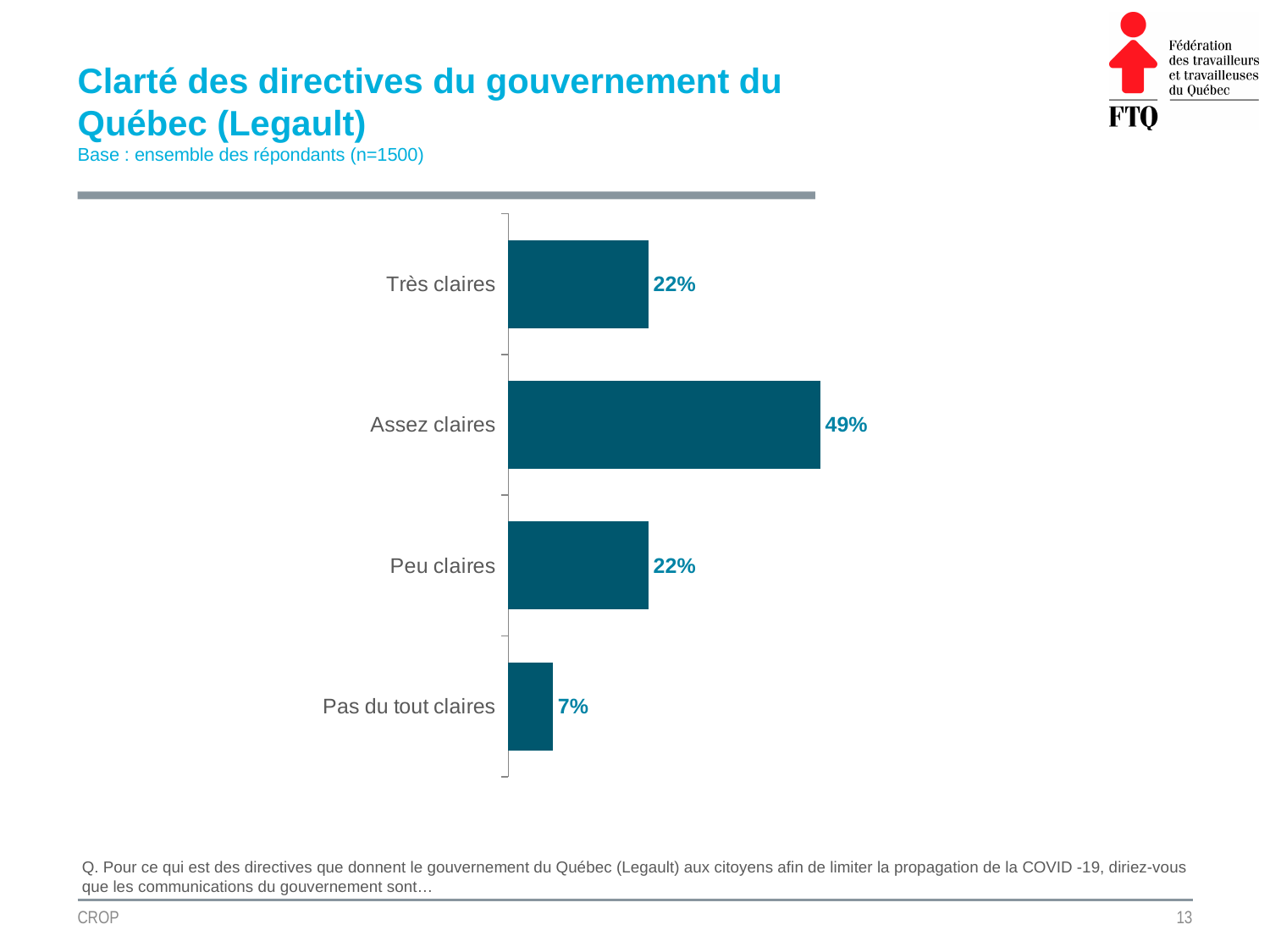
Which is larger, the value for "Assez claires" or the value for "Très claires"? Assez claires What is the difference between the values for "Peu claires" and "Pas du tout claires"? 15% What is the combined value of "Très claires" and "Assez claires"? 71% What is the value for "Pas du tout claires"? 7% What is the difference between the values for "Assez claires" and "Peu claires"? 27% How many categories are shown in the chart? 4 What is the value for "Assez claires"? 49% What is the title of the chart on the slide? Clarté des directives du gouvernement du Québec (Legault) What kind of chart is shown on the slide? Bar chart What is the value for "Très claires"? 22% Which category has the lowest value? Pas du tout claires Which category has the highest value? Assez claires